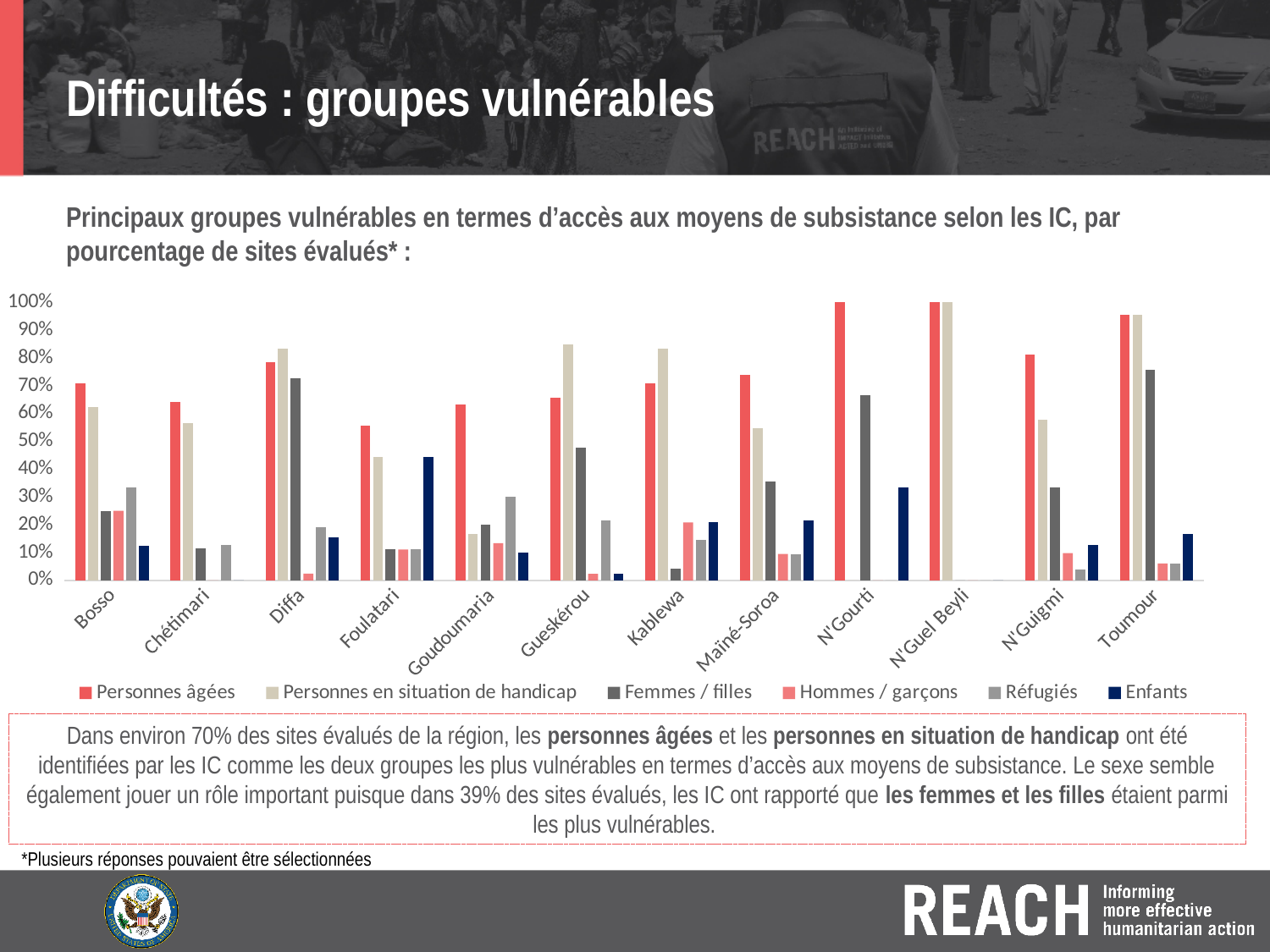
Which locality has the highest value for Enfants? Foulatari Which locality has the highest value for Personnes en situation de handicap? N'Guel Beyli Which locality has the highest value for Femmes / filles? Toumour What is the value for Personnes âgées in N'Gourti? 100% Which series is shown in dark blue in the legend? Enfants Which is larger: Femmes / filles in Diffa or Femmes / filles in Bosso? Diffa Is the value for Femmes / filles in N'Gourti greater or less than 60%? greater How many localities (categories) are shown on the x axis? 12 What is the value for Personnes en situation de handicap in N'Guel Beyli? 100% Is the value for Personnes en situation de handicap in Bosso greater or less than 50%? greater What kind of chart is shown on the slide? bar chart How many series does the legend list? 6